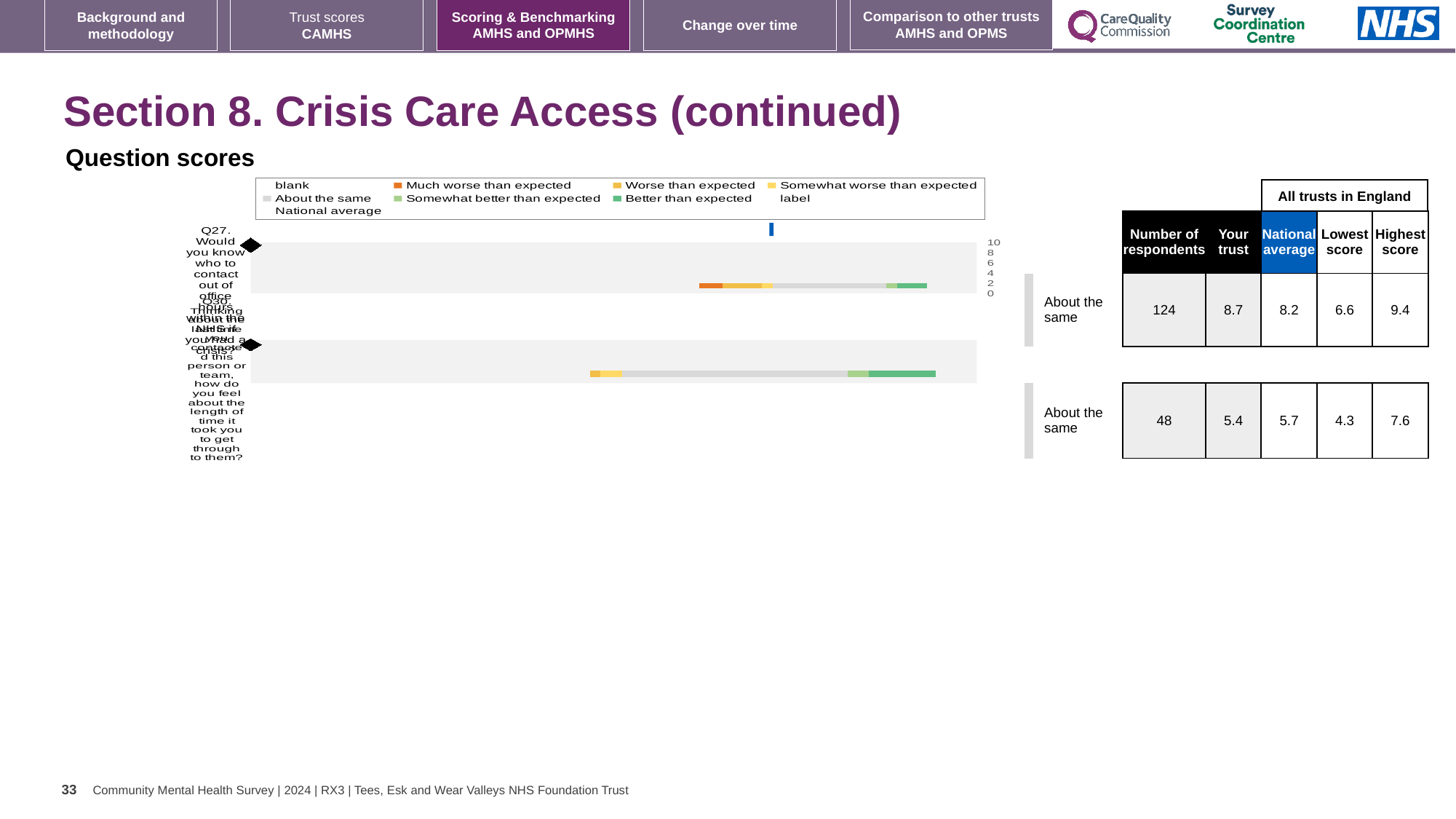
What is the lowest score across all trusts in England for Q30? 4.3 How many respondents answered Q27? 124 What is the difference between the highest score and the lowest score for Q27? 2.8 What benchmark category is shown for Q30? About the same What kind of chart is shown under 'Question scores'? bar chart How many questions (categories) are plotted in the chart? 2 How many entries does the chart legend list? 9 For Q27, which is larger: the 'Your trust' score or the national average? Your trust What is the 'Your trust' score for Q27? 8.7 What is the national average score for Q30? 5.7 What colour does the legend use for 'Much worse than expected'? orange Which question has the higher 'Your trust' score, Q27 or Q30? Q27